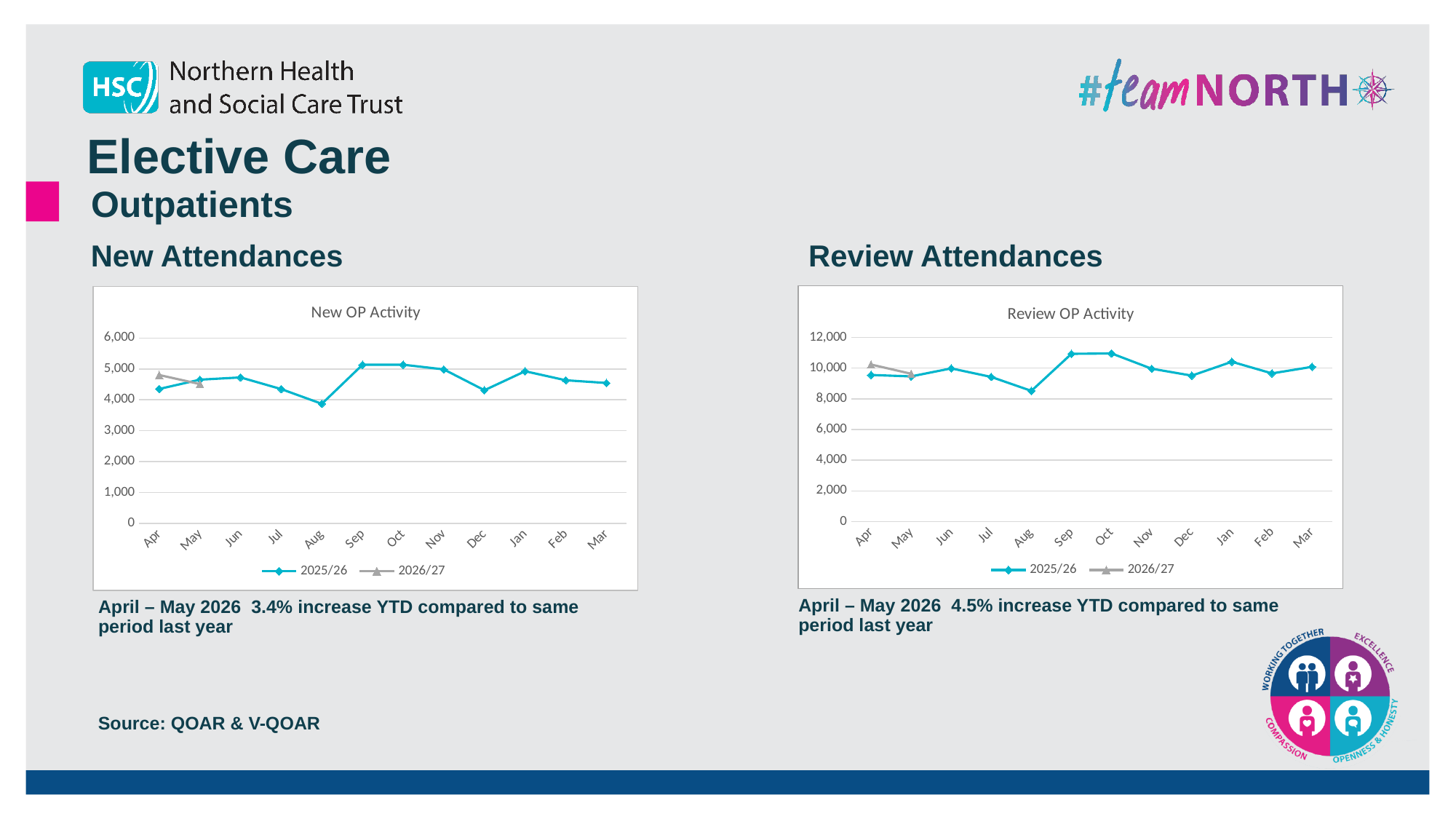
In the New OP Activity chart, which is larger for Apr: the 2025/26 value or the 2026/27 value? 2026/27 In the Review OP Activity chart, is the 2025/26 value for Aug greater or less than 10,000? less What type of chart is the New OP Activity chart? line chart How many months are shown on the x axis of the New OP Activity chart? 12 In the New OP Activity chart, which month has the lowest value for the 2025/26 series? Aug In the Review OP Activity chart, which month has the lowest value for the 2025/26 series? Aug In the New OP Activity chart, is the 2025/26 value for Aug greater or less than 4,000? less In the New OP Activity chart, is the 2025/26 value for Sep greater or less than 5,000? greater What are the two series names in the legend of the New OP Activity chart? 2025/26 and 2026/27 How many series does the legend of the Review OP Activity chart list? 2 In the Review OP Activity chart, which 2025/26 value is larger: Aug or Jan? Jan